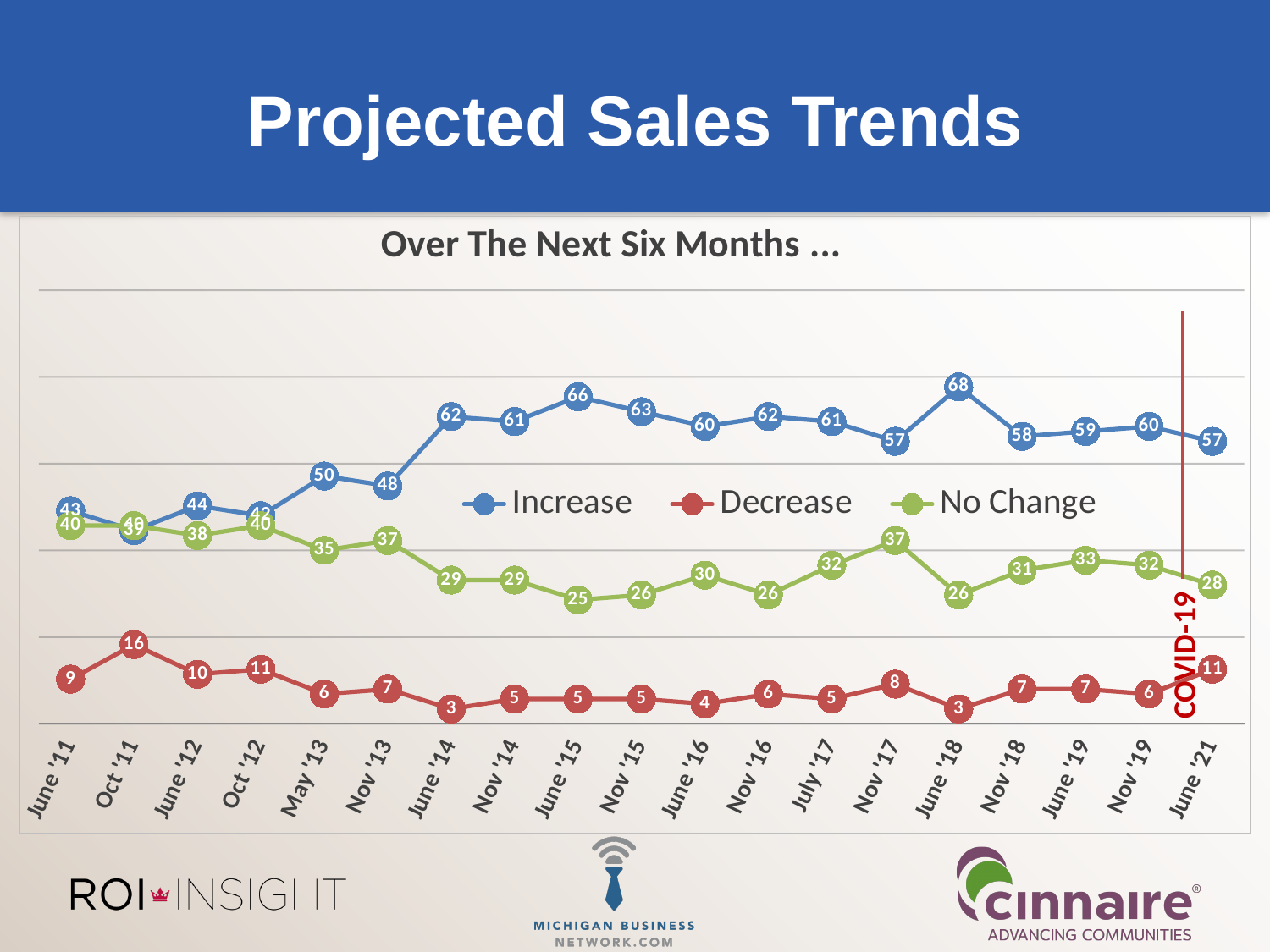
At which date is the Decrease series at its highest? Oct '11 What is the value of the No Change series at June '21? 28 What is the value of the Increase series at June '18? 68 What is the difference between the Increase value at June '18 and at June '21? 11 What is the value of the Decrease series at Oct '11? 16 At Nov '19, which is larger: the Increase value or the Decrease value? Increase How many series does the legend list? 3 What label is written next to the vertical red line near the right of the chart? COVID-19 At which date is the No Change series at its lowest? June '15 How many dates are plotted along the x axis? 19 What kind of chart is shown on the slide? Line chart At which date does the Increase series reach its highest value? June '18